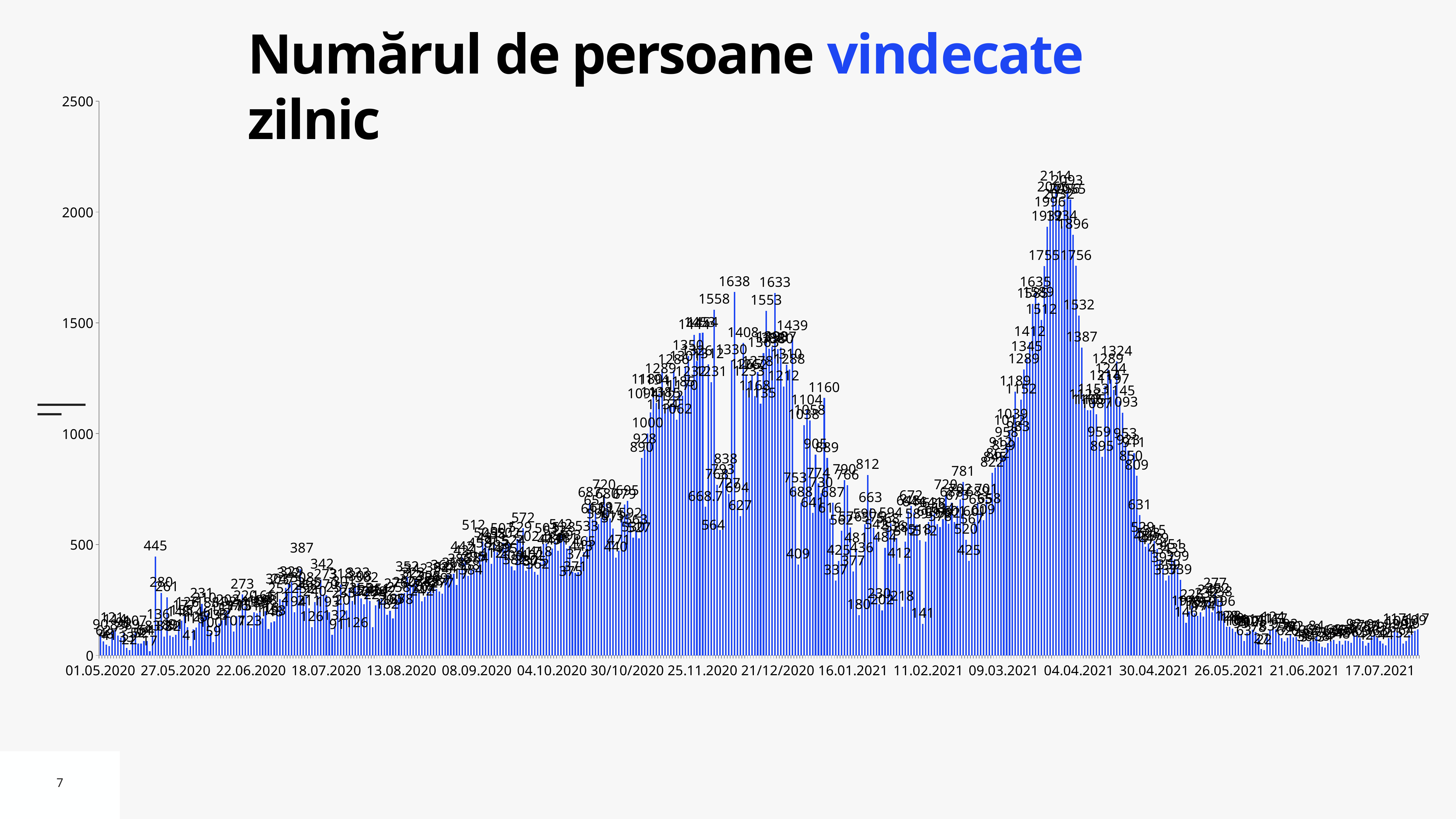
Is the highest daily value on the chart greater or less than 2000? greater What is the maximum value shown on the vertical axis? 2500 How many date labels are shown on the horizontal axis? 18 What is the highest value labelled in the peak between 25.11.2020 and 21/12/2020? 1638 Are the values around 17.07.2021 greater or less than 500? less What is the difference between the labelled values 1638 and 1633 in the late-2020 peak? 5 Do the values rise or fall between 04.04.2021 and 30.04.2021? fall What is the highest value labelled on the chart? 2114 What kind of chart is shown on the slide? bar chart Do the values rise or fall between 09.03.2021 and 04.04.2021? rise What is the title of the chart? Numărul de persoane vindecate zilnic Which is larger: the peak value around 04.04.2021 (2114) or the peak value around 21/12/2020 (1638)? 2114